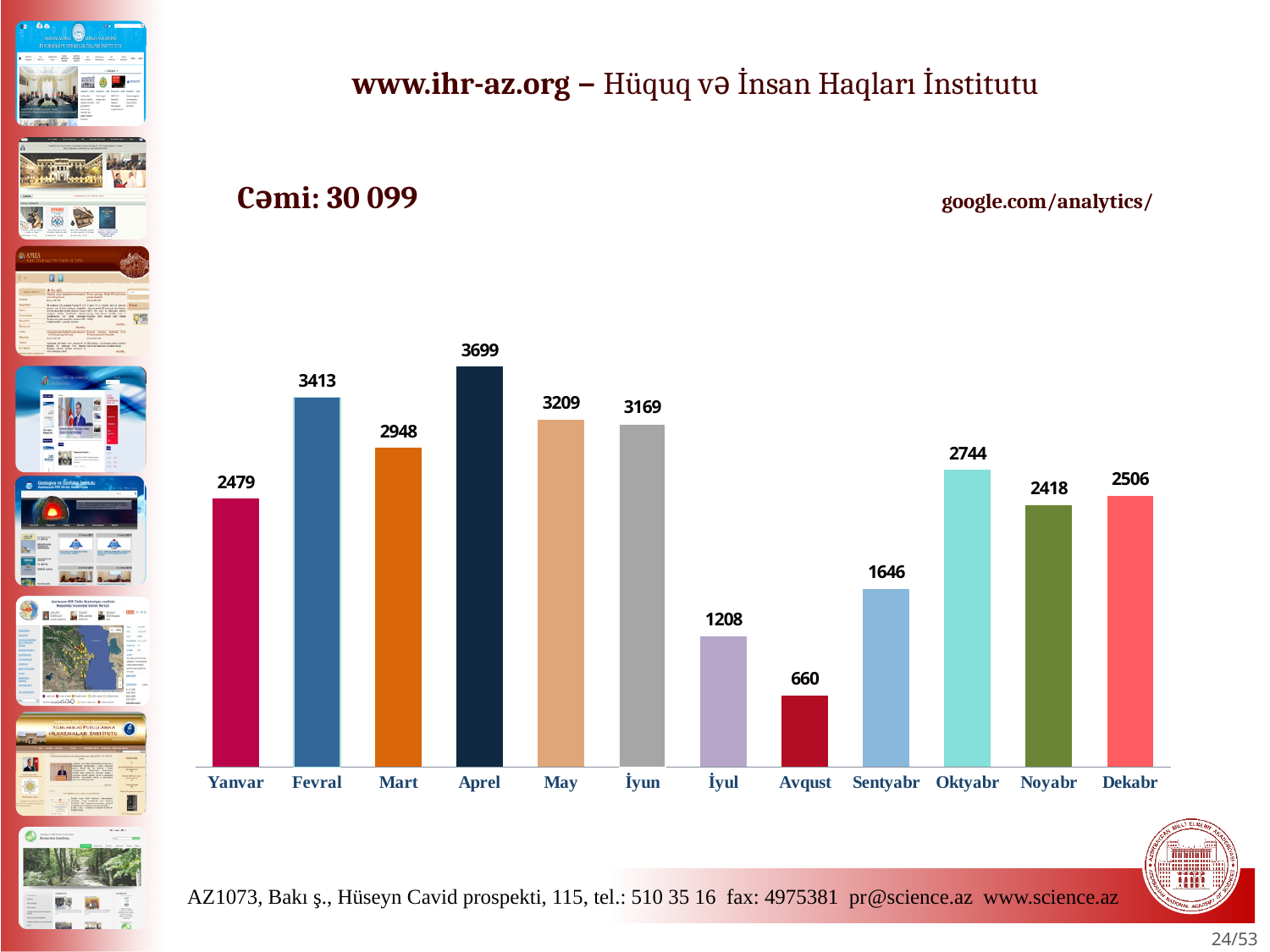
What is the value for Aprel? 3699 How many months are shown on the chart? 12 Which is larger, the value for May or the value for İyun? May What is the value for Sentyabr? 1646 What kind of chart is shown on the slide? Bar chart What is the difference between the values for Oktyabr and Noyabr? 326 Do the values rise or fall from Aprel to Avqust? Fall Which month has the highest value? Aprel What is the difference between the values for Fevral and Mart? 465 What is the value for Avqust? 660 Which is larger, the value for Yanvar or the value for Dekabr? Dekabr Which month has the lowest value? Avqust